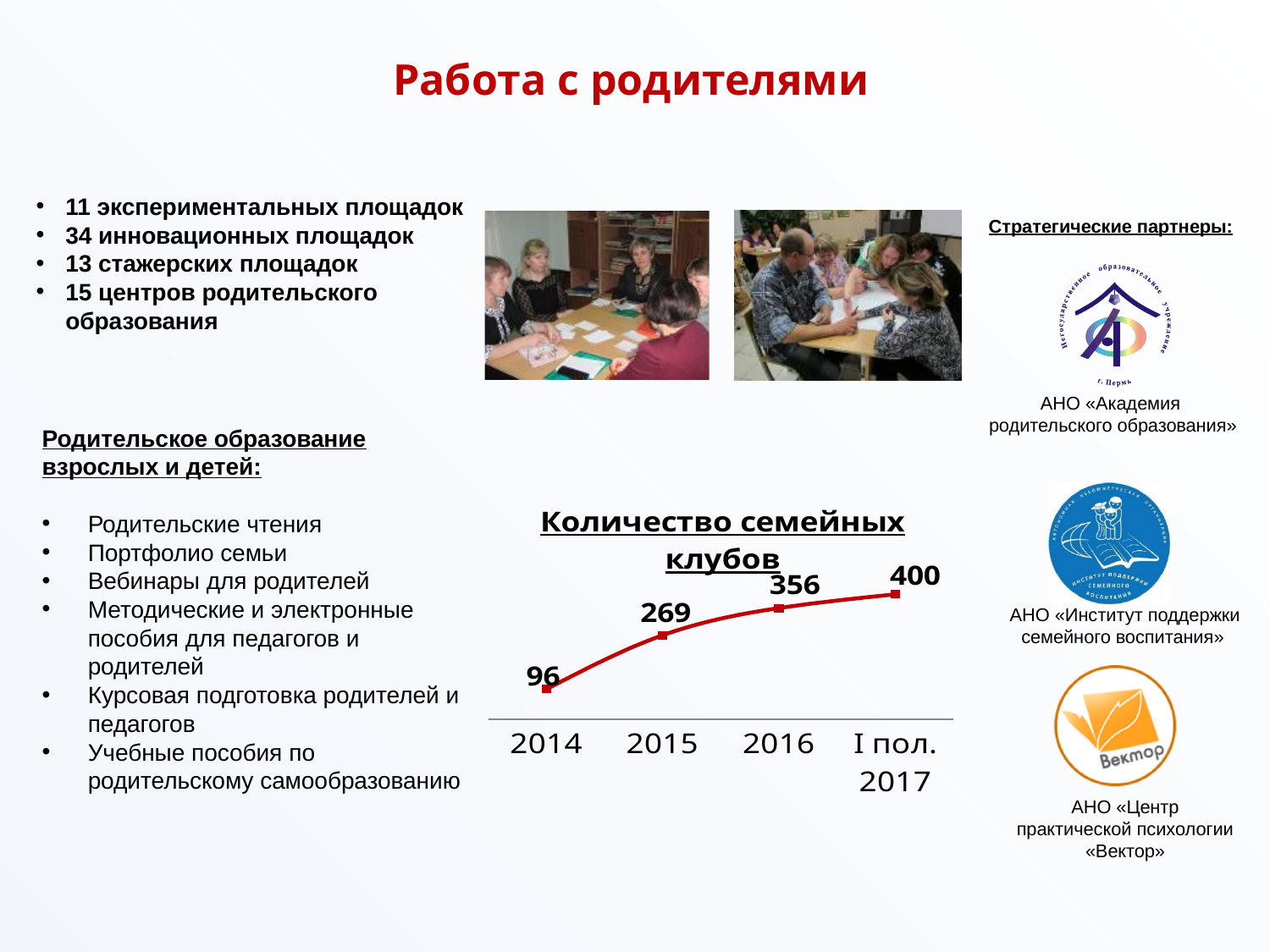
Which category has the highest value in the chart 'Количество семейных клубов'? I пол. 2017 Which category has the lowest value in the chart 'Количество семейных клубов'? 2014 What is the value for 2015 in the chart 'Количество семейных клубов'? 269 How many data points are plotted in the chart 'Количество семейных клубов'? 4 What is the value for 2016 in the chart 'Количество семейных клубов'? 356 What is the difference between the values for 'I пол. 2017' and 2016 in the chart 'Количество семейных клубов'? 44 What is the value for 'I пол. 2017' in the chart 'Количество семейных клубов'? 400 Do the values in the chart 'Количество семейных клубов' rise or fall from 2014 to I пол. 2017? rise What is the value for 2014 in the chart 'Количество семейных клубов'? 96 What is the difference between the values for 2015 and 2014 in the chart 'Количество семейных клубов'? 173 Which is larger in the chart 'Количество семейных клубов': the value for 2016 or the value for 2015? 2016 What kind of chart is 'Количество семейных клубов'? line chart